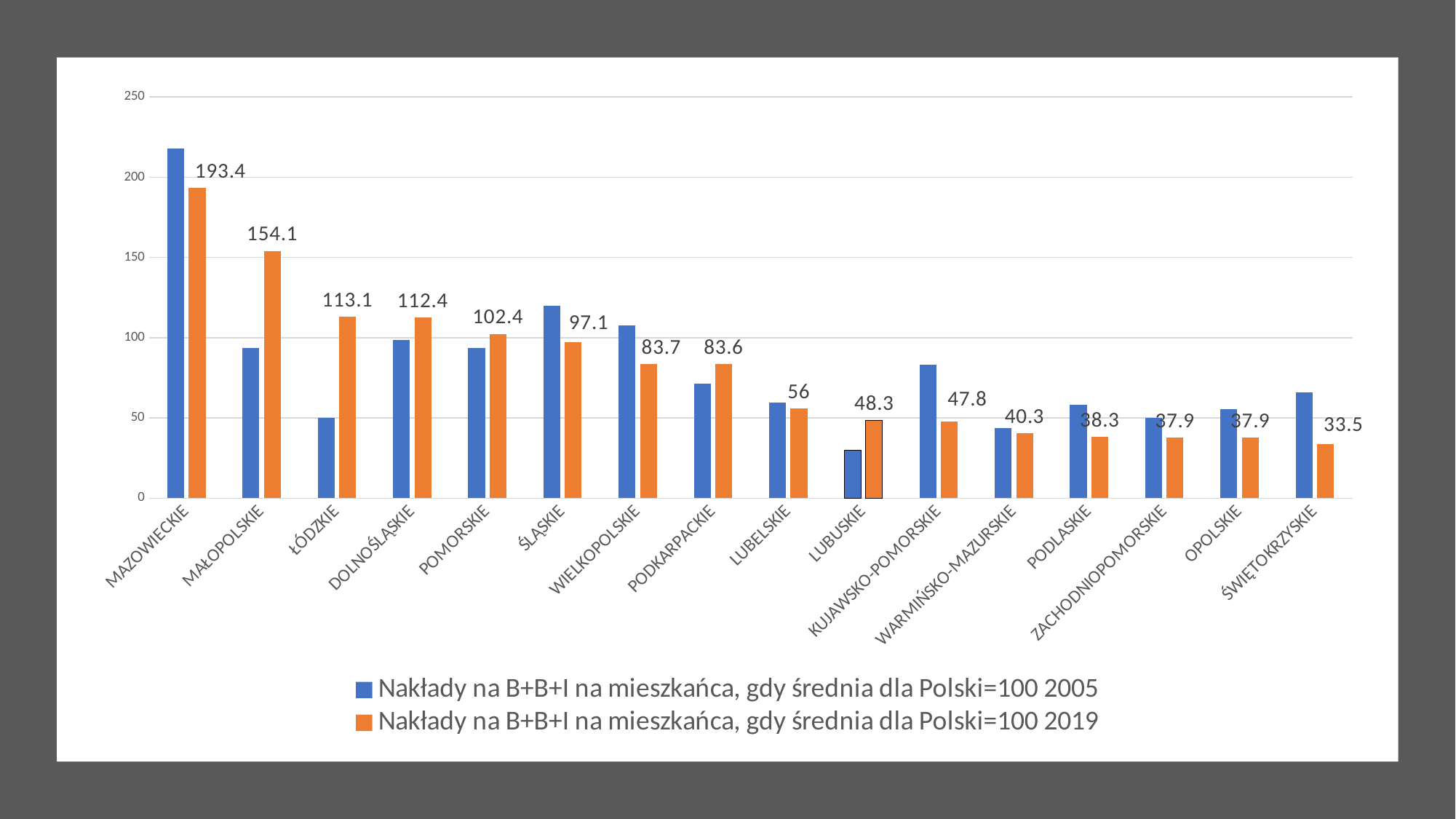
Which region has the highest 2019 value? MAZOWIECKIE Is the 2005 value for ŁÓDZKIE greater or less than 100? less How many regions are shown on the x axis? 16 What is the 2019 value for MAZOWIECKIE? 193.4 How many series does the legend list? 2 Which region has the lowest 2019 value? ŚWIĘTOKRZYSKIE What is the 2019 value for LUBUSKIE? 48.3 What is the difference between the 2019 values for MAZOWIECKIE and MAŁOPOLSKIE? 39.3 Which has the larger 2019 value, POMORSKIE or ŚLĄSKIE? POMORSKIE What is the 2019 value for ŚWIĘTOKRZYSKIE? 33.5 Do the 2019 values rise or fall from left to right along the x axis? fall Is the 2005 value for MAZOWIECKIE greater or less than 200? greater